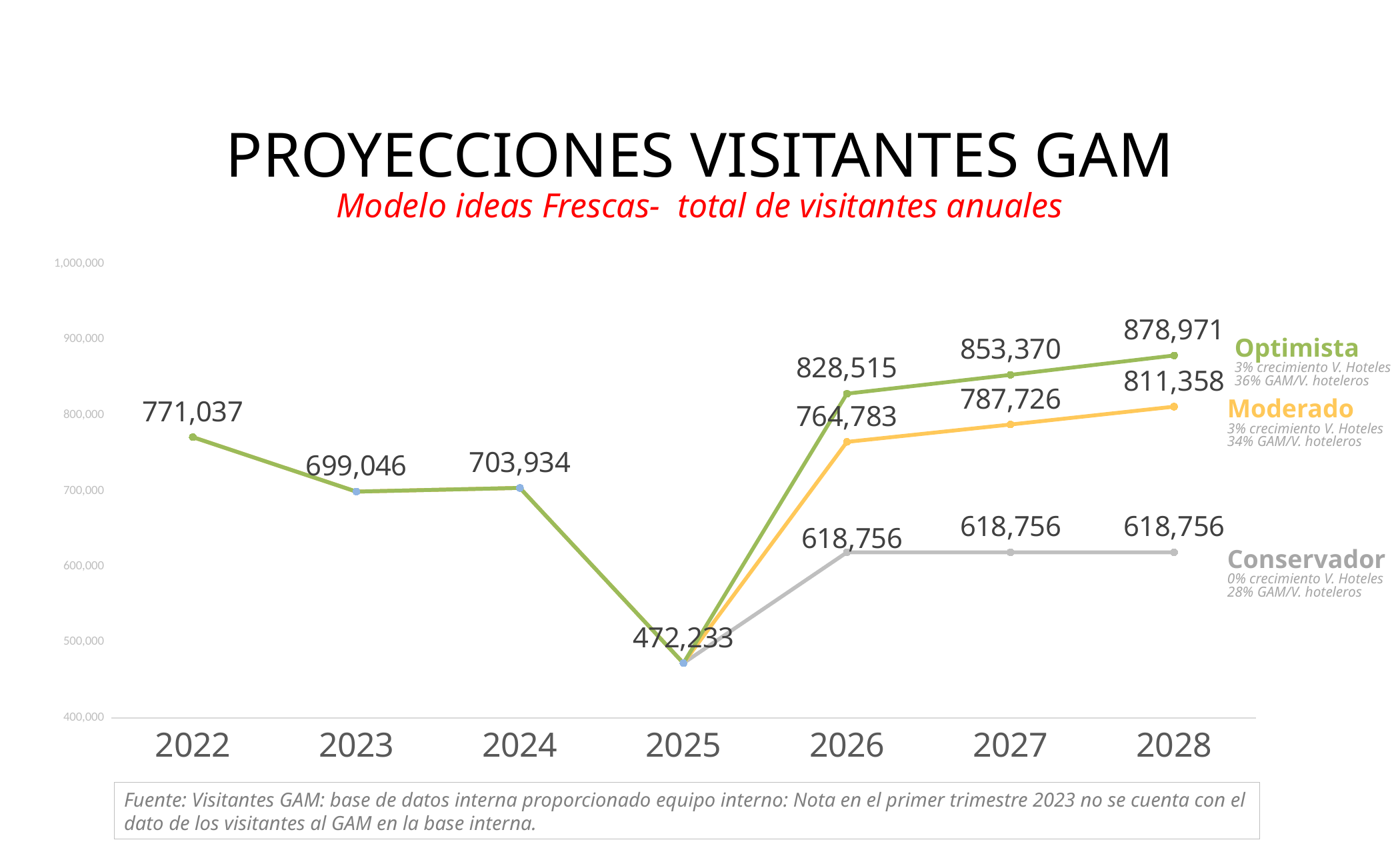
What is the projected value for the Conservador scenario in 2026? 618,756 What is the difference between the Optimista and Moderado projections for 2028? 67,613 Which year has the larger value, 2023 or 2024? 2024 Which year has the lowest number of visitors on the chart? 2025 Does the Conservador scenario rise, fall or stay flat from 2026 to 2028? Stays flat What kind of chart is shown on the slide? Line chart What is the projected value for the Moderado scenario in 2027? 787,726 How many years are shown on the x axis? 7 What is the difference between the 2022 value and the 2025 value? 298,804 How many projection scenarios are labelled on the chart? 3 What is the total number of visitors shown for 2022? 771,037 What is the projected value for the Optimista scenario in 2028? 878,971